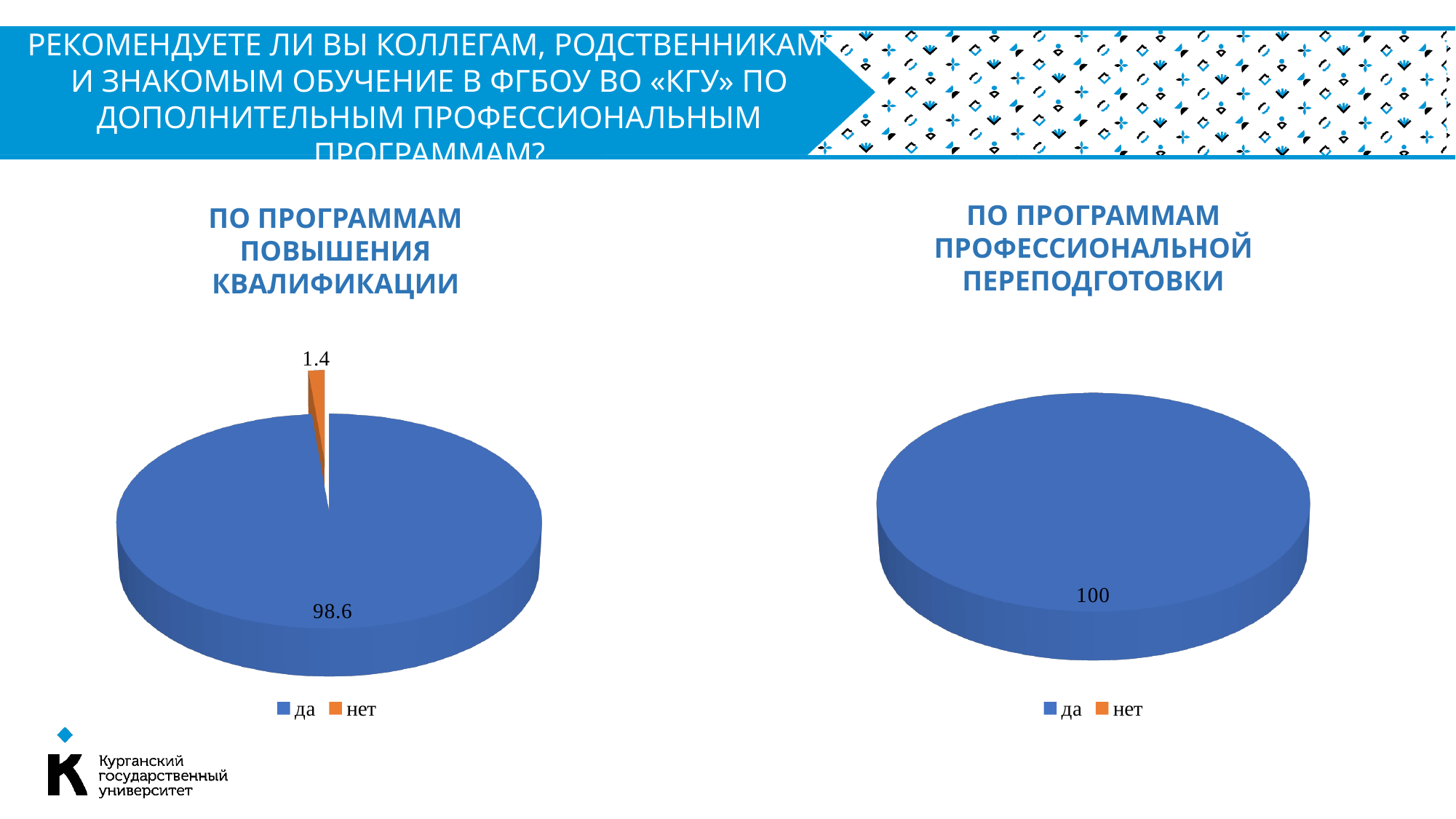
In the left chart (ПО ПРОГРАММАМ ПОВЫШЕНИЯ КВАЛИФИКАЦИИ), what is the value for "нет"? 1.4 What kind of chart is the left chart (ПО ПРОГРАММАМ ПОВЫШЕНИЯ КВАЛИФИКАЦИИ)? Pie chart In the left chart (ПО ПРОГРАММАМ ПОВЫШЕНИЯ КВАЛИФИКАЦИИ), which category has the smallest slice? нет In the left chart (ПО ПРОГРАММАМ ПОВЫШЕНИЯ КВАЛИФИКАЦИИ), what is the value for "да"? 98.6 In the right chart (ПО ПРОГРАММАМ ПРОФЕССИОНАЛЬНОЙ ПЕРЕПОДГОТОВКИ), what colour is the "да" slice? Blue What is the title of the right chart? ПО ПРОГРАММАМ ПРОФЕССИОНАЛЬНОЙ ПЕРЕПОДГОТОВКИ In the left chart (ПО ПРОГРАММАМ ПОВЫШЕНИЯ КВАЛИФИКАЦИИ), which category has the largest slice? да In the left chart (ПО ПРОГРАММАМ ПОВЫШЕНИЯ КВАЛИФИКАЦИИ), which is larger, "да" or "нет"? да In the left chart (ПО ПРОГРАММАМ ПОВЫШЕНИЯ КВАЛИФИКАЦИИ), what is the difference between the values for "да" and "нет"? 97.2 In the right chart (ПО ПРОГРАММАМ ПРОФЕССИОНАЛЬНОЙ ПЕРЕПОДГОТОВКИ), what value is printed on the pie? 100 What kind of chart is the right chart (ПО ПРОГРАММАМ ПРОФЕССИОНАЛЬНОЙ ПЕРЕПОДГОТОВКИ)? Pie chart How many entries does the legend of the left chart (ПО ПРОГРАММАМ ПОВЫШЕНИЯ КВАЛИФИКАЦИИ) list? 2